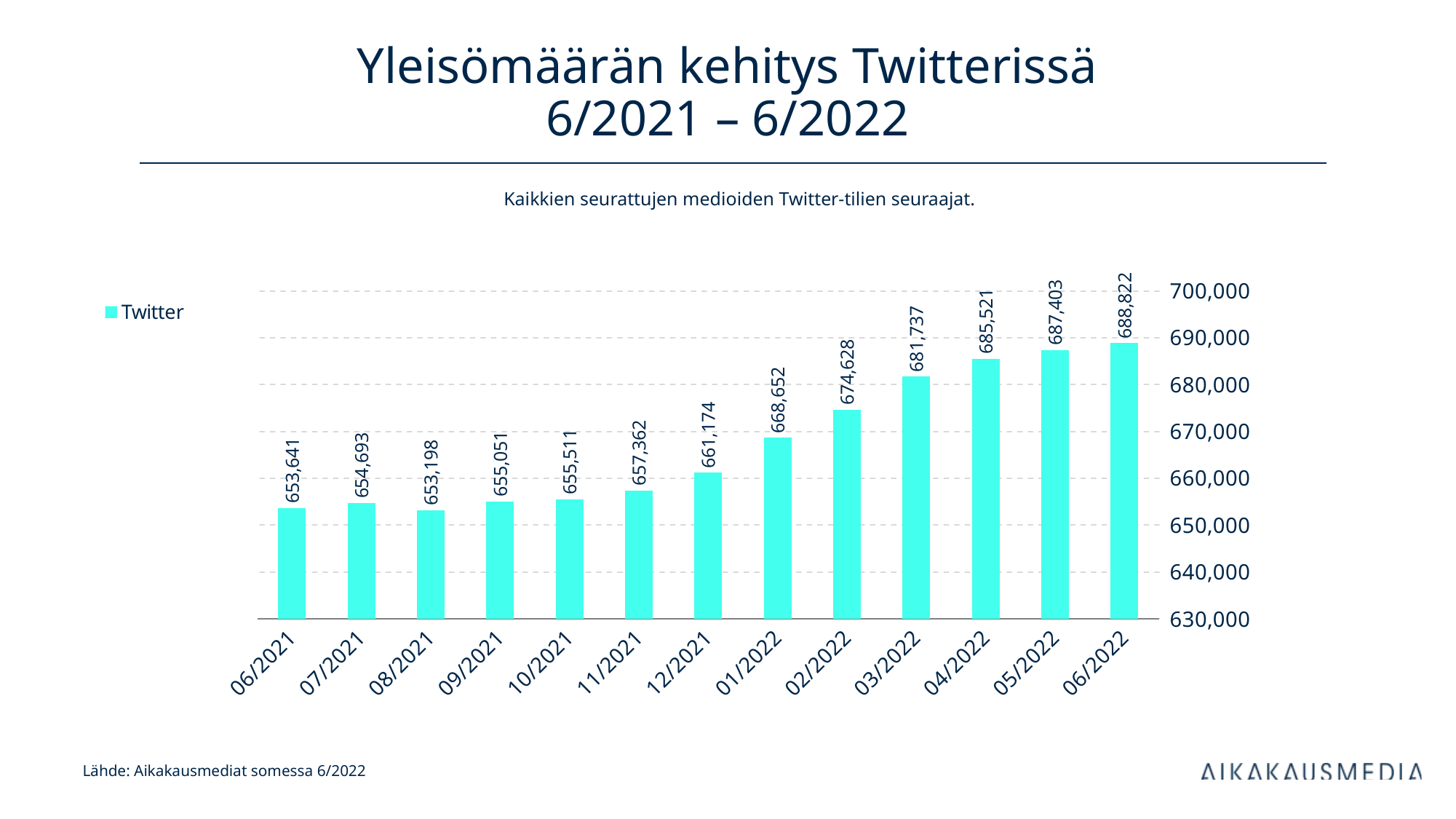
What kind of chart is shown on the slide? bar chart How many series does the legend list? 1 Which is larger, the value for 12/2021 or the value for 02/2022? 02/2022 Is the value for 03/2022 greater or less than 680,000? greater Which month has the lowest value? 08/2021 What is the value for 01/2022? 668,652 What is the value for 06/2021? 653,641 How many months are shown on the x axis? 13 What is the value for 06/2022? 688,822 Which month has the highest value? 06/2022 What is the difference between the values for 06/2022 and 06/2021? 35,181 Do the values generally rise or fall from 06/2021 to 06/2022? rise